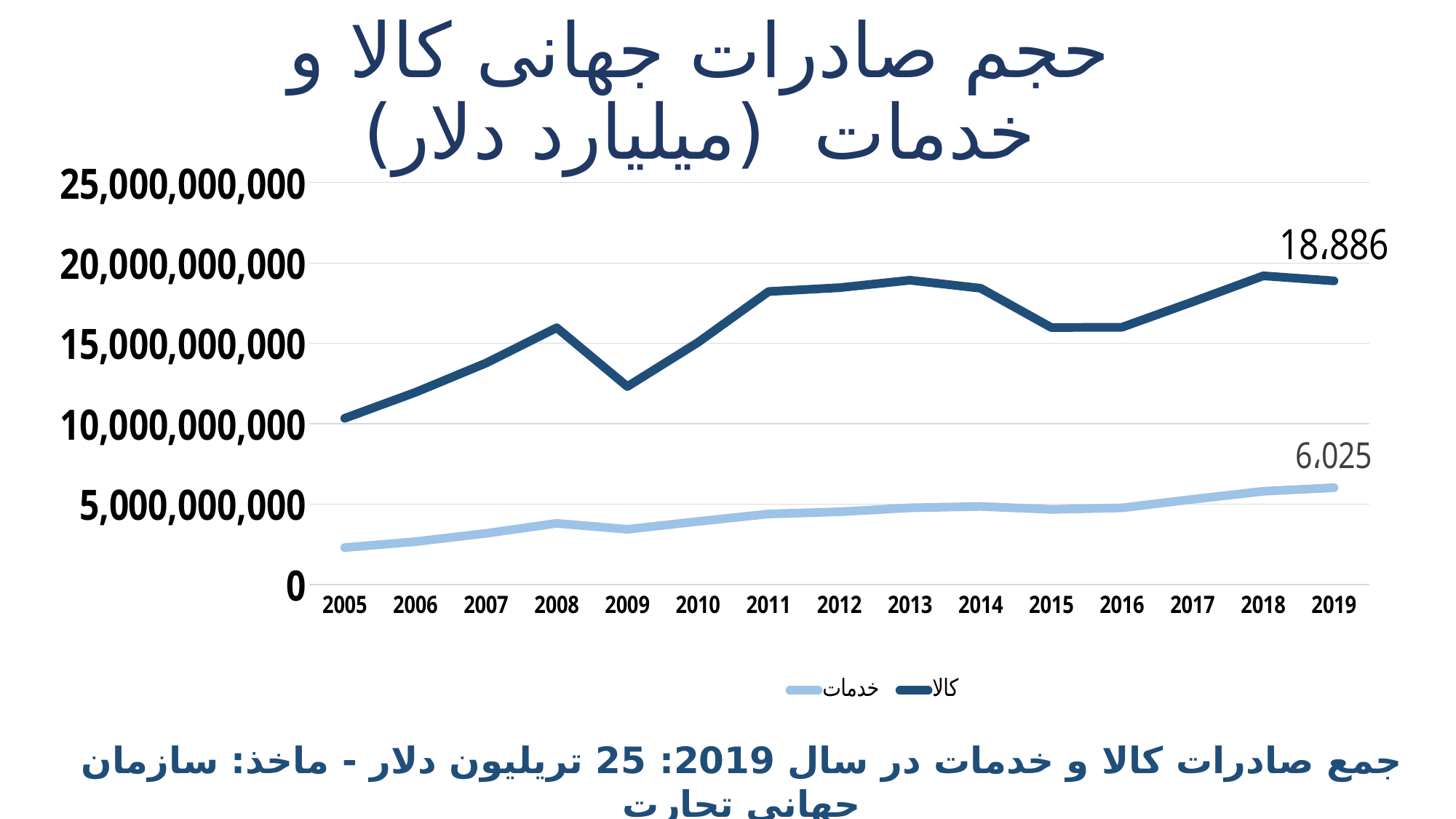
Which year has the lowest value for کالا? 2005 What is the data label shown for کالا in 2019? 18,886 Is the value for کالا in 2005 greater or less than 15,000,000,000? less Is the value for کالا in 2013 greater or less than 15,000,000,000? greater What is the difference between the labelled 2019 values for کالا and خدمات? 12,861 Is the value for خدمات in 2005 greater or less than 5,000,000,000? less What kind of chart is shown on the slide? line chart In 2019, which series has the larger value, کالا or خدمات? کالا What is the data label shown for خدمات in 2019? 6,025 Does the value for کالا rise or fall from 2008 to 2009? fall How many series does the legend list? 2 How many years are shown on the x axis? 15